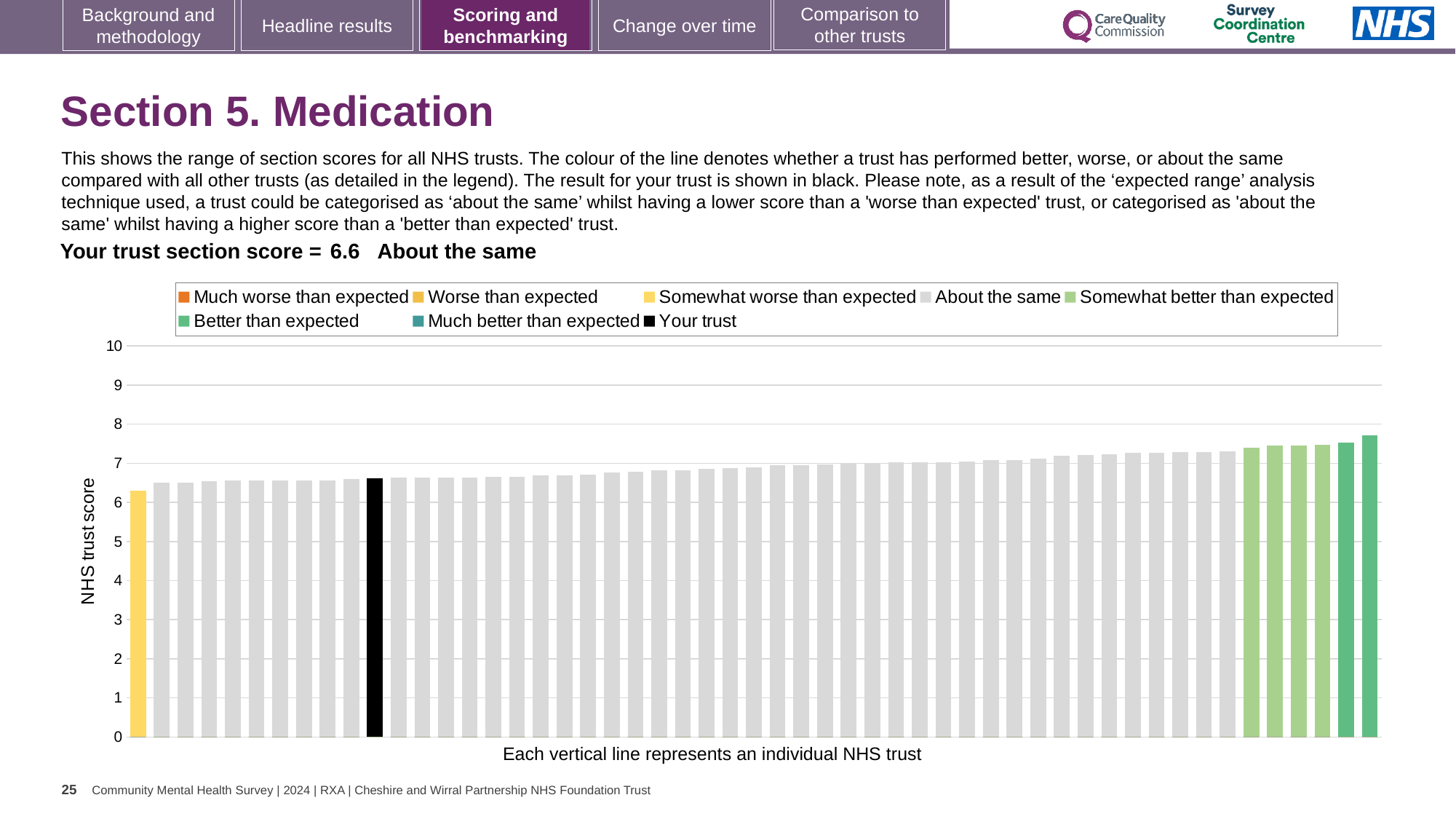
Is the value for your trust (the black bar) greater or less than 7? less Is the value for your trust (the black bar) greater or less than 6? greater Is the value of the shortest bar (the leftmost yellow bar) greater or less than 6? greater What colour is the bar representing your trust? black What is the label on the vertical axis of the chart? NHS trust score What kind of chart is shown on the slide? bar chart Do the bar values rise or fall from left to right along the x axis? rise What is the section score for your trust shown on the slide? 6.6 Which category is your trust placed in according to the text above the chart? About the same How many entries does the chart legend list? 8